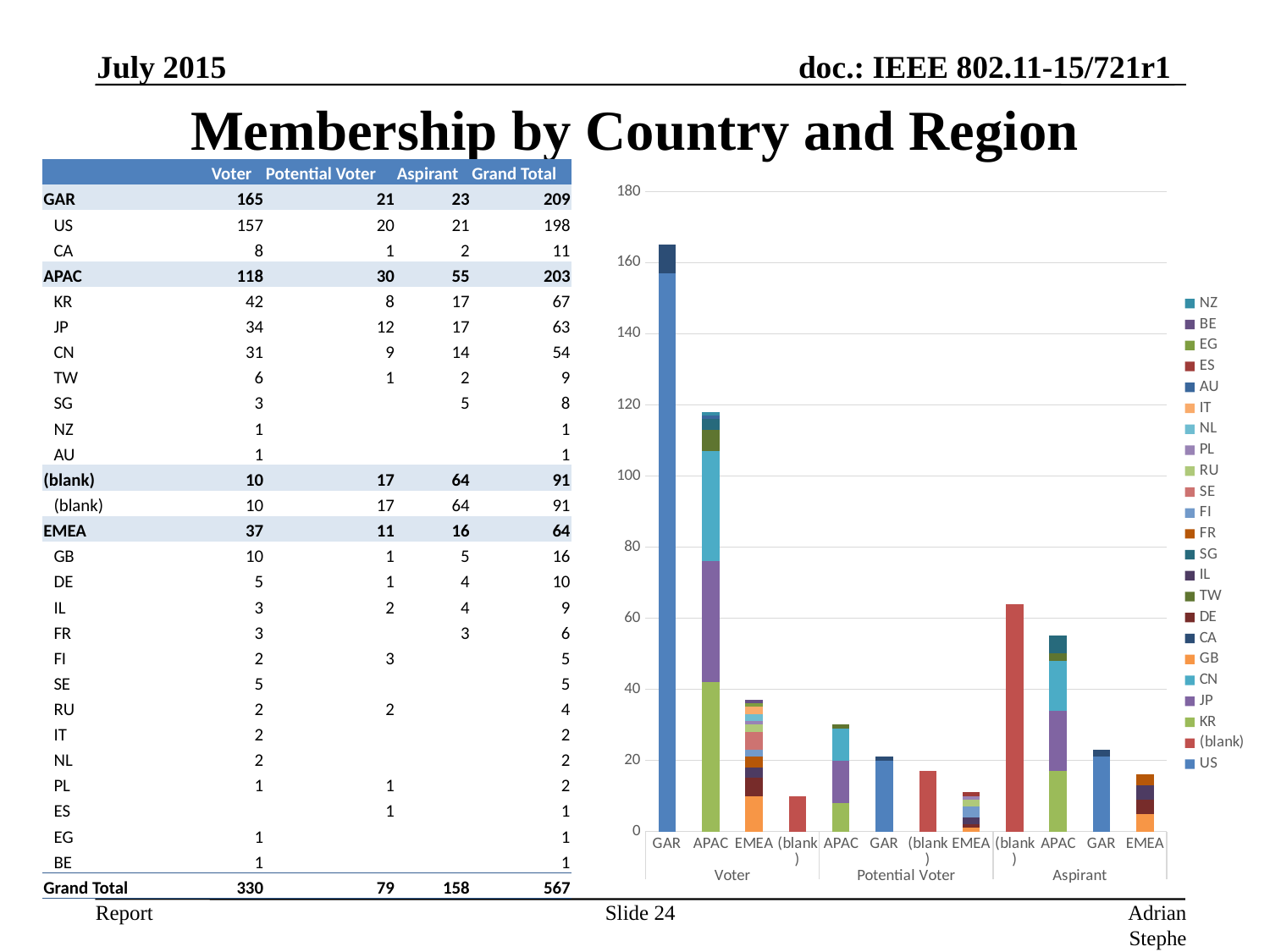
How many series does the chart legend list? 23 How many stacked bars are plotted in the chart? 12 In the Aspirant group, which bar is taller: APAC or GAR? APAC What is the total of the GAR stacked bar in the Voter group, as given in the table? 165 Within the Voter group, which bar is the shortest? (blank) Which is taller: the EMEA bar in the Voter group or the APAC bar in the Potential Voter group? EMEA in Voter Is the value of the (blank) bar in the Aspirant group greater or less than 40? greater Which bar in the chart is the tallest? GAR under Voter What kind of chart is shown on the slide? bar chart What are the three groups labelled along the x axis of the chart? Voter, Potential Voter, Aspirant Is the value of the APAC bar in the Voter group greater or less than 100? greater Is the value of the GAR bar in the Voter group greater or less than 140? greater